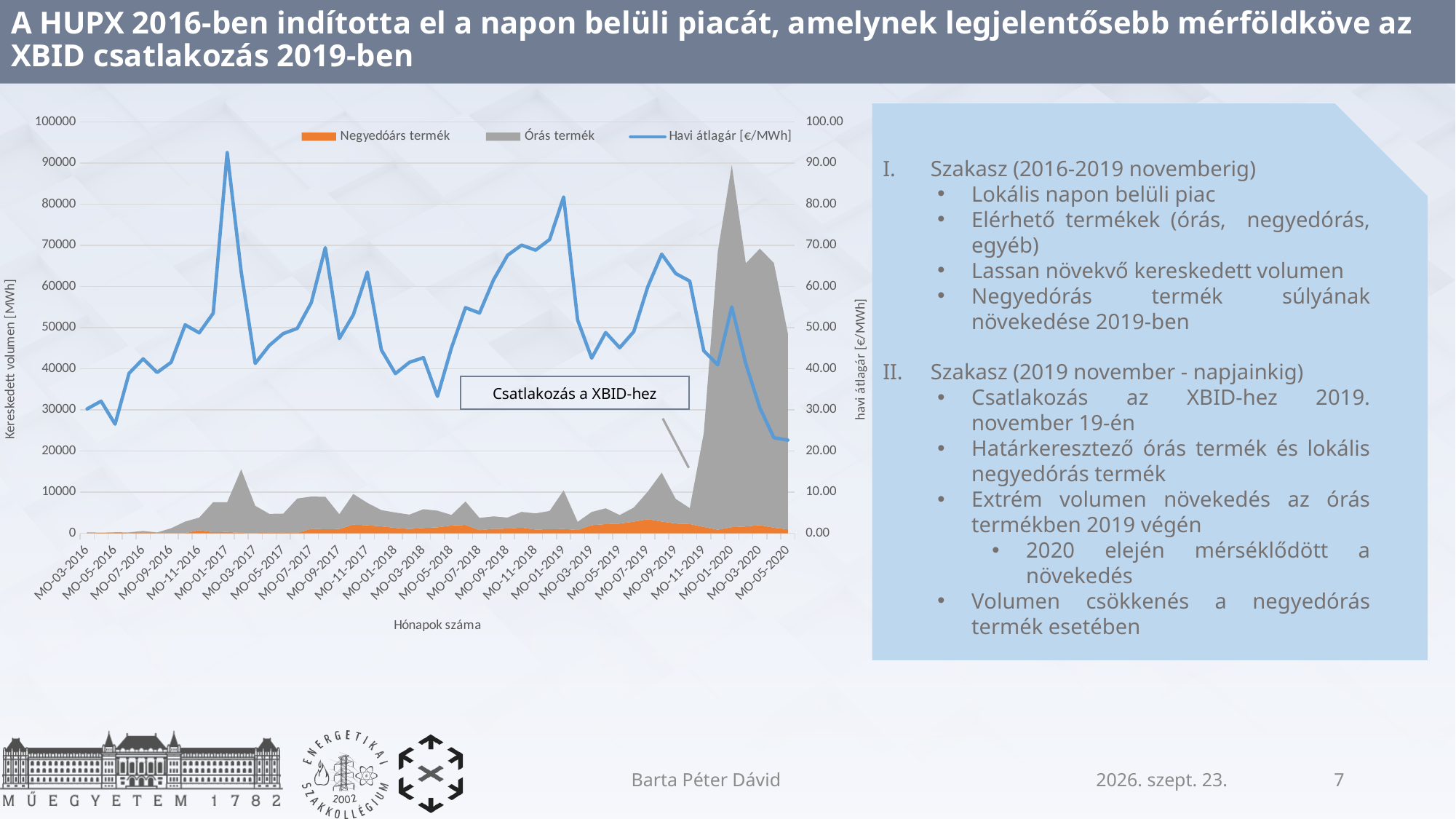
Which is larger, the Órás termék value at MO-01-2020 or at MO-03-2017? MO-01-2020 How many series does the chart legend list? 3 Does the Havi átlagár line rise or fall between MO-01-2020 and MO-05-2020? fall Is the Órás termék value at MO-01-2020 greater or less than 80000? greater Is the Havi átlagár value at MO-01-2017 greater or less than 80.00? greater Is the Havi átlagár value at MO-03-2016 greater or less than 40.00? less At which month does the Havi átlagár line reach its highest value? MO-01-2017 Which is larger, the Havi átlagár value at MO-01-2017 or at MO-01-2019? MO-01-2017 At which month does the Órás termék series reach its highest value? MO-01-2020 What are the three series named in the chart legend? Negyedóárs termék, Órás termék, Havi átlagár [€/MWh] What is the title of the chart's x axis? Hónapok száma